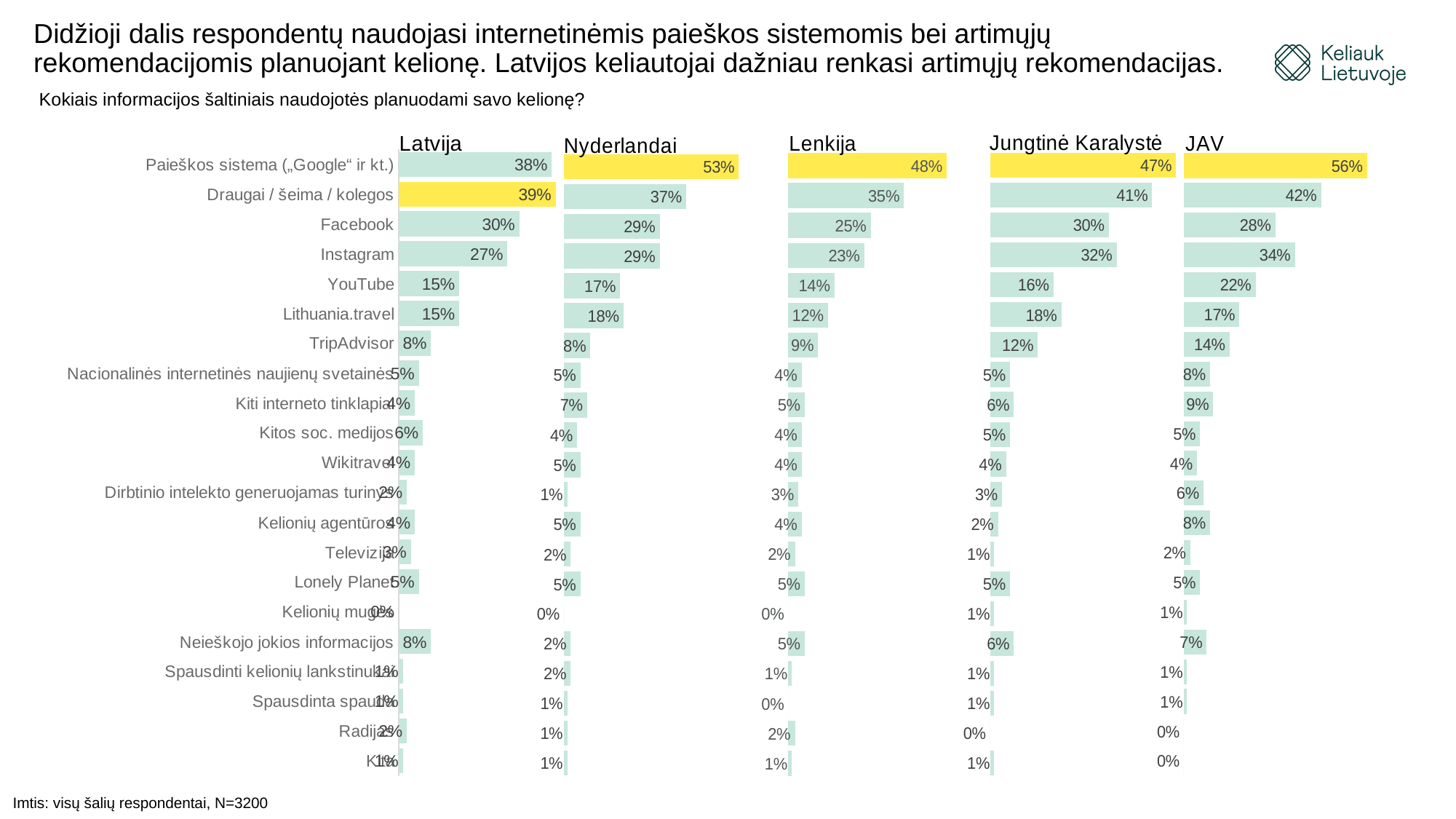
In the Jungtinė Karalystė chart, what is the value for Instagram? 32% How many categories are listed in the Lenkija chart? 21 In the JAV chart, what is the difference between Paieškos sistema („Google“ ir kt.) and Draugai / šeima / kolegos? 14% In the JAV chart, which is larger: Facebook or Instagram? Instagram In the Nyderlandai chart, what is the difference between Paieškos sistema („Google“ ir kt.) and Facebook? 24% In the Lenkija chart, what is the value for Facebook? 25% In the JAV chart, what is the value for Paieškos sistema („Google“ ir kt.)? 56% In the Jungtinė Karalystė chart, which is larger: YouTube or Lithuania.travel? Lithuania.travel In the Nyderlandai chart, which category has the highest value? Paieškos sistema („Google“ ir kt.) In the Latvija chart, what is the value for Draugai / šeima / kolegos? 39% In the Latvija chart, which category has the highest value? Draugai / šeima / kolegos What type of chart is used for the Latvija data? Bar chart